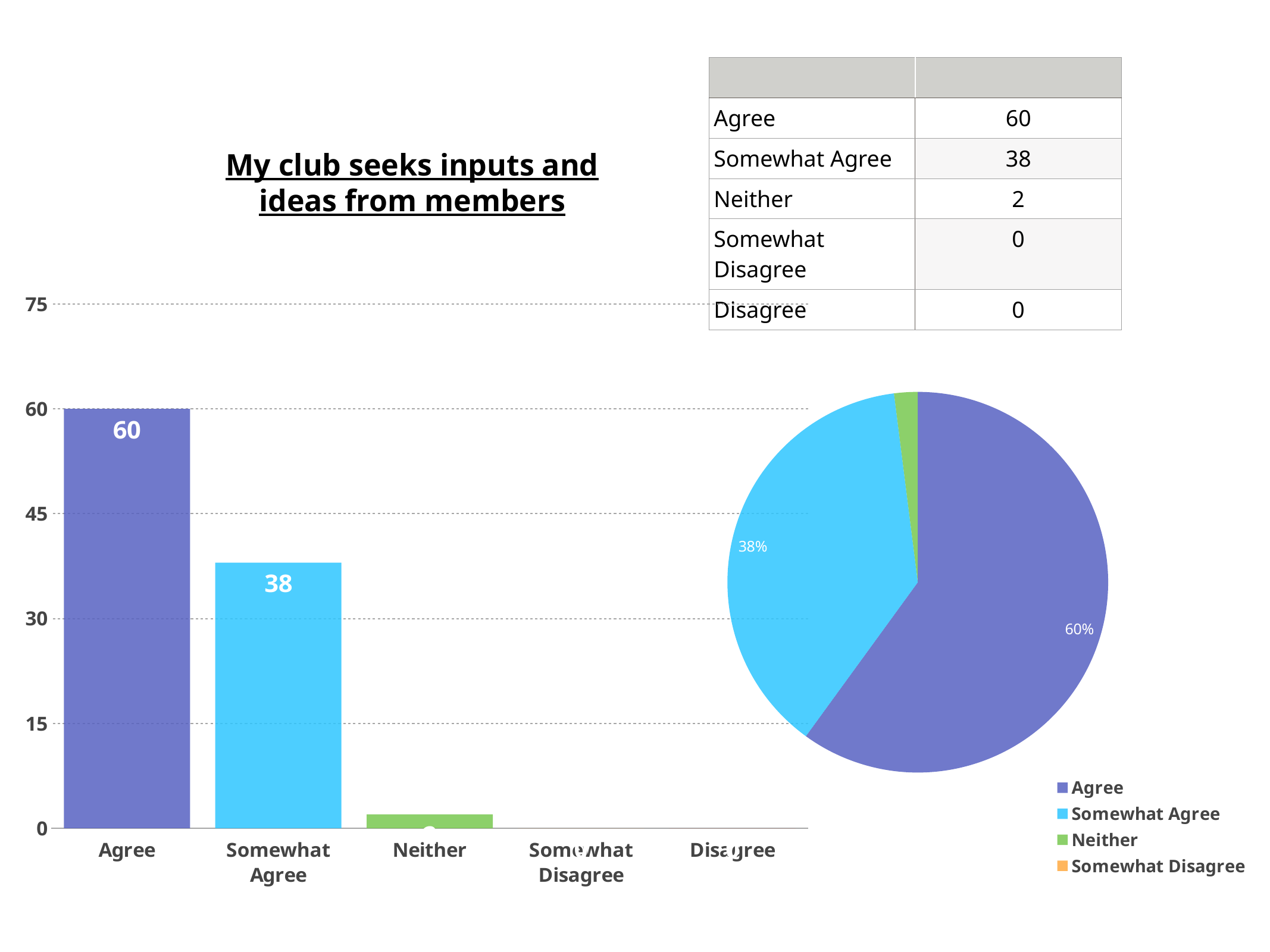
How many entries does the legend of the pie chart list? 4 In the bar chart, is the value for Neither greater or less than 15? less What kind of chart is the chart on the left of the slide? bar chart In the pie chart, what share does the Somewhat Agree slice represent? 38% In the bar chart, what is the value for Somewhat Agree? 38 How many categories are shown on the x axis of the bar chart? 5 What kind of chart is the chart on the right of the slide? pie chart In the bar chart, what is the value for Agree? 60 In the bar chart, what is the difference between the values for Agree and Somewhat Agree? 22 In the pie chart, what share does the Agree slice represent? 60% In the bar chart, which is larger, the value for Somewhat Agree or the value for Neither? Somewhat Agree In the bar chart, which category has the highest value? Agree